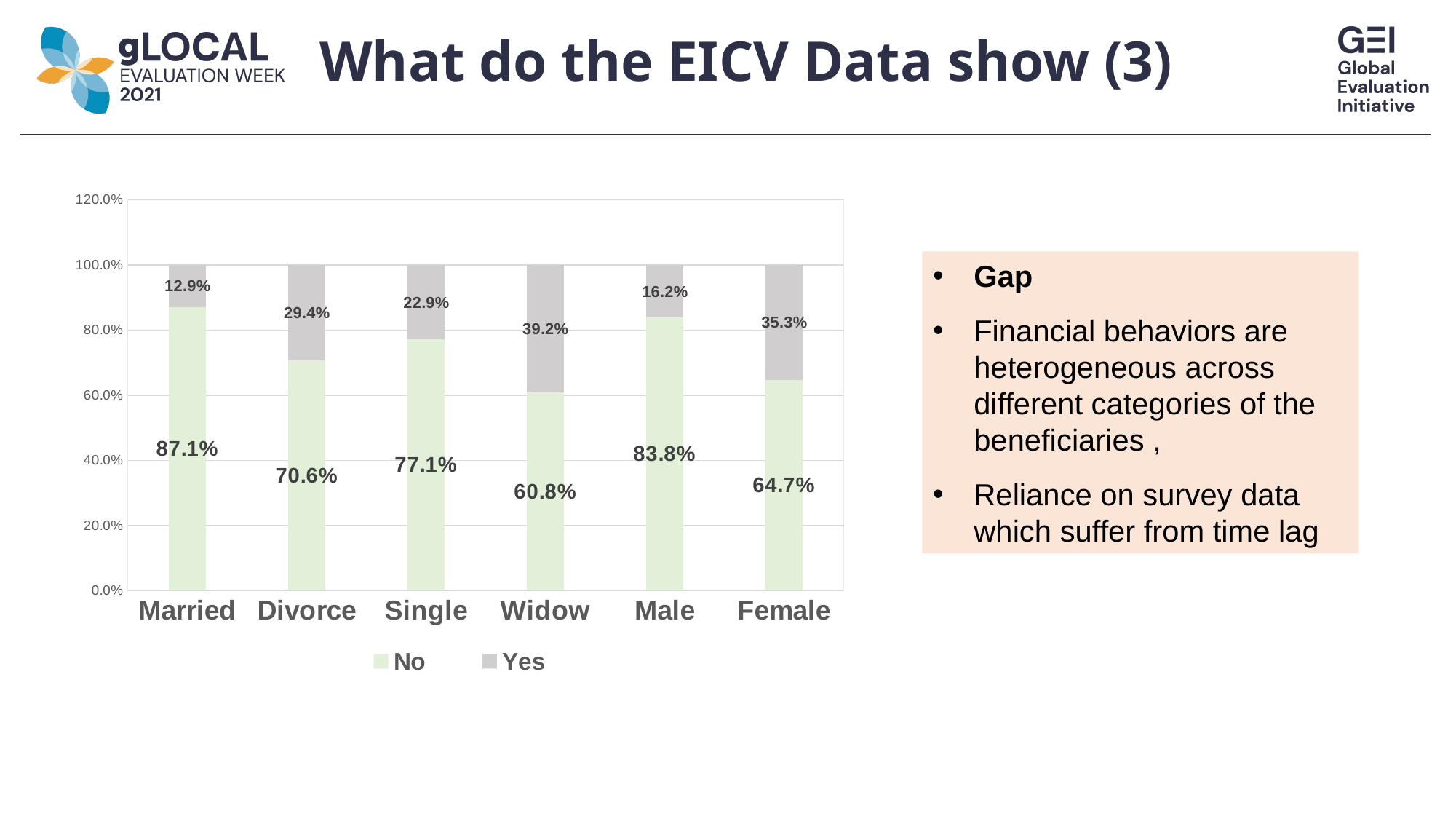
How many categories are shown on the x axis? 6 Which category has the highest 'No' value? Married What is the 'No' value for Married? 87.1% Which category has the lowest 'No' value? Widow What is the difference between the 'No' values for Married and Divorce? 16.5% What is the 'Yes' value for Widow? 39.2% What is the 'No' value for Male? 83.8% Which category has the highest 'Yes' value? Widow How many series does the legend list? 2 What is the 'Yes' value for Female? 35.3% Which is larger, the 'Yes' value for Single or the 'Yes' value for Divorce? Divorce What kind of chart is shown on the slide? Stacked bar chart